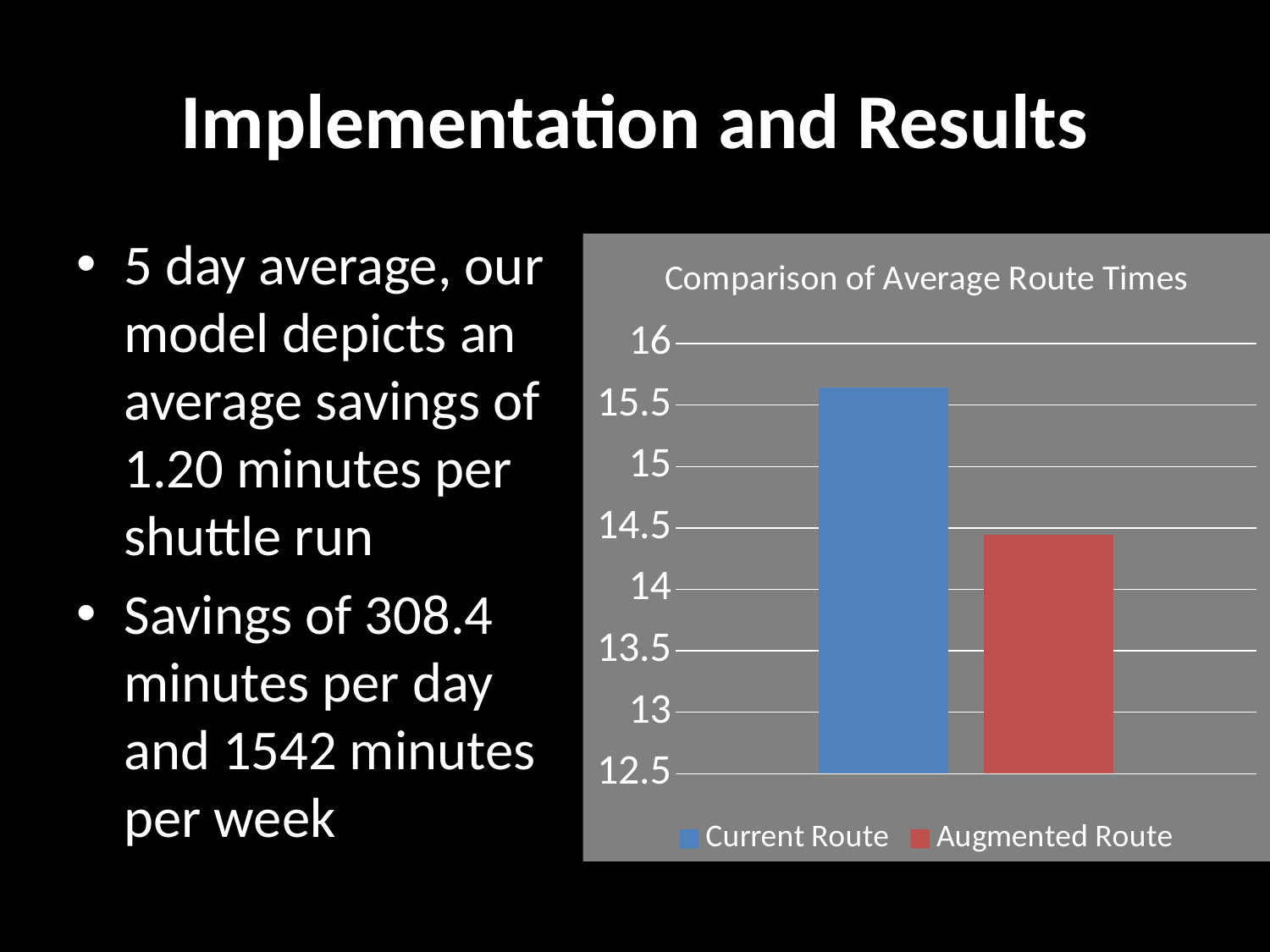
Which series has the highest value in the chart? Current Route Is the value for Current Route greater or less than 15? greater Is the value for Current Route greater or less than 16? less What kind of chart is shown on the slide? bar chart What is the title of the chart? Comparison of Average Route Times Is the value for Augmented Route greater or less than 14? greater Which series has the lowest value in the chart? Augmented Route What are the two series named in the chart legend? Current Route and Augmented Route How many series does the chart legend list? 2 How many bars are plotted in the chart? 2 Which series has the higher average route time, Current Route or Augmented Route? Current Route